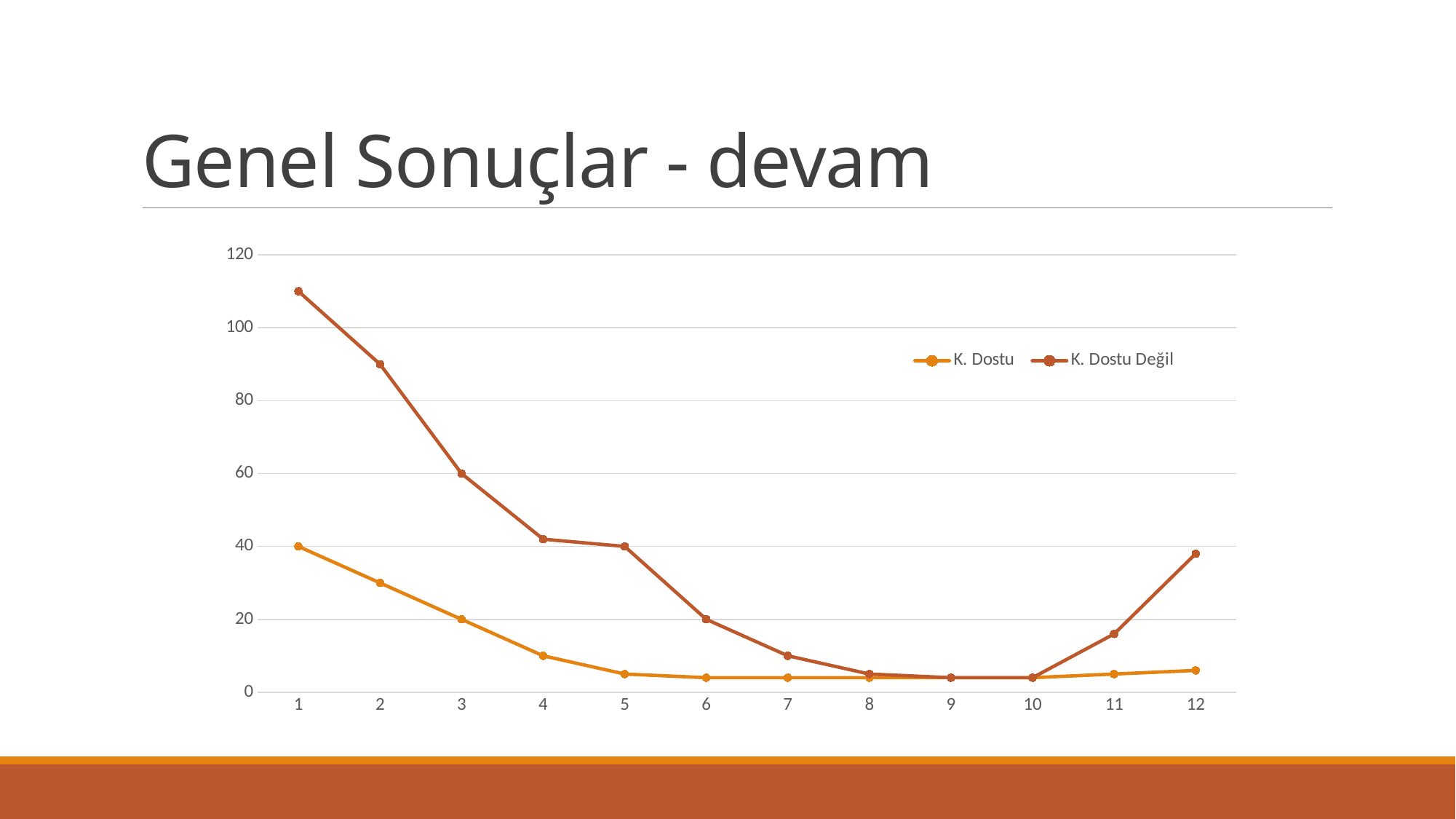
How many points are plotted along the x axis for each series? 12 What is the title of the slide containing the chart? Genel Sonuçlar - devam At point 12, which series has the larger value, K. Dostu or K. Dostu Değil? K. Dostu Değil What is the value of K. Dostu Değil at point 6? 20 What is the value of K. Dostu at point 1? 40 What is the value of K. Dostu Değil at point 3? 60 What kind of chart is shown on the slide? line chart How many series does the legend list? 2 Does the K. Dostu series rise or fall from point 1 to point 5? fall Is the value for K. Dostu Değil at point 1 greater or less than 100? greater At which x-axis point does K. Dostu Değil reach its highest value? 1